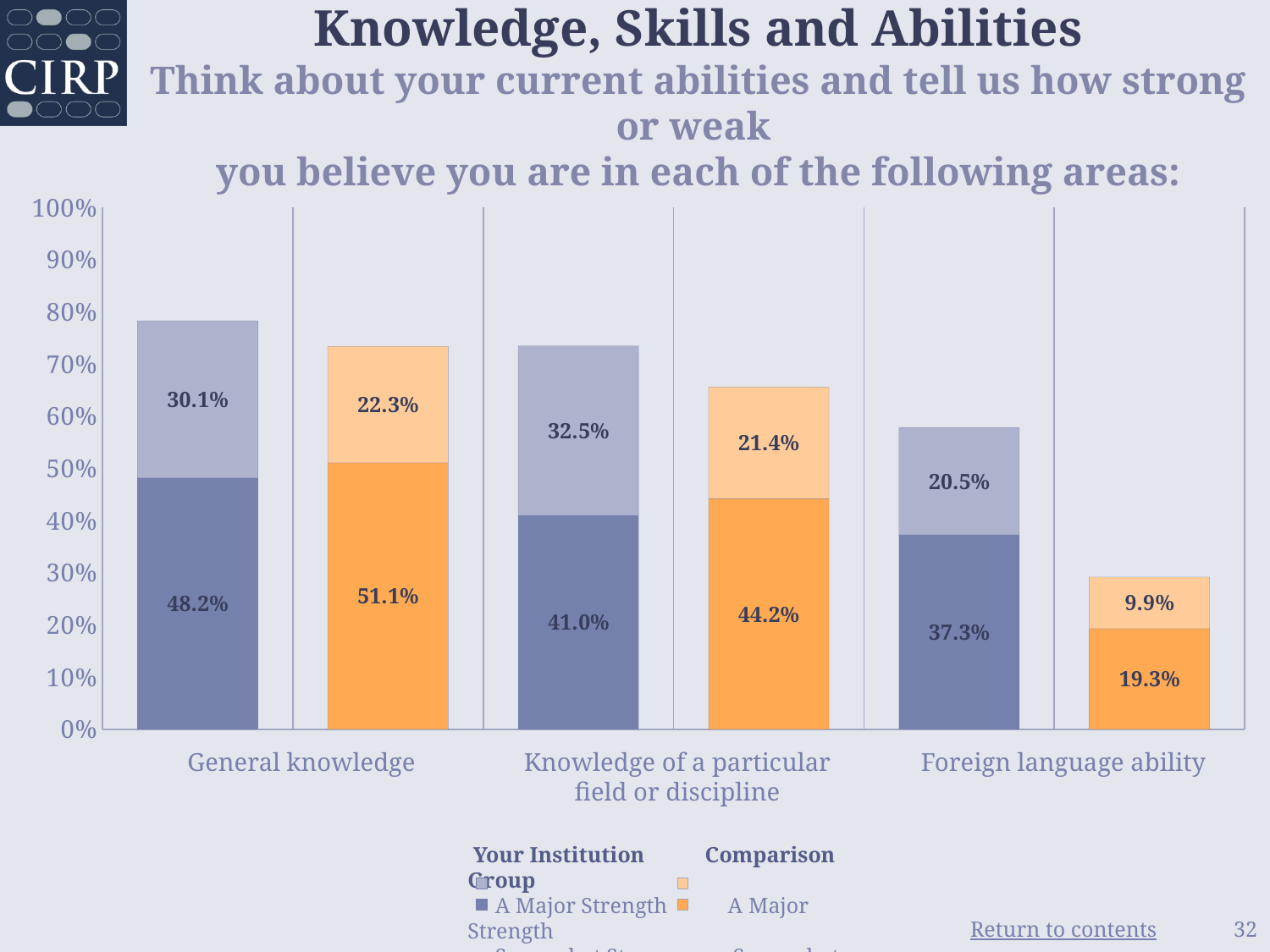
What is the total height of the Your Institution stacked bar for General knowledge? 78.3% Which is larger: the 'A Major Strength' value for Your Institution or for the Comparison Group in Knowledge of a particular field or discipline? Comparison Group How many categories are shown along the x axis? 3 What is the 'Somewhat Strong' value for the Comparison Group in General knowledge? 22.3% Which category has the lowest 'A Major Strength' value for the Comparison Group? Foreign language ability What is the 'Somewhat Strong' value for Your Institution in Knowledge of a particular field or discipline? 32.5% What is the 'A Major Strength' value for Your Institution in General knowledge? 48.2% What is the total height of the Comparison Group stacked bar for Foreign language ability? 29.2% Is the total height of the Your Institution stacked bar for Foreign language ability greater or less than 50%? greater What kind of chart is shown on the slide? stacked bar chart What is the difference between the 'A Major Strength' values for Your Institution and the Comparison Group in Foreign language ability? 18.0% What is the 'A Major Strength' value for the Comparison Group in Foreign language ability? 19.3%